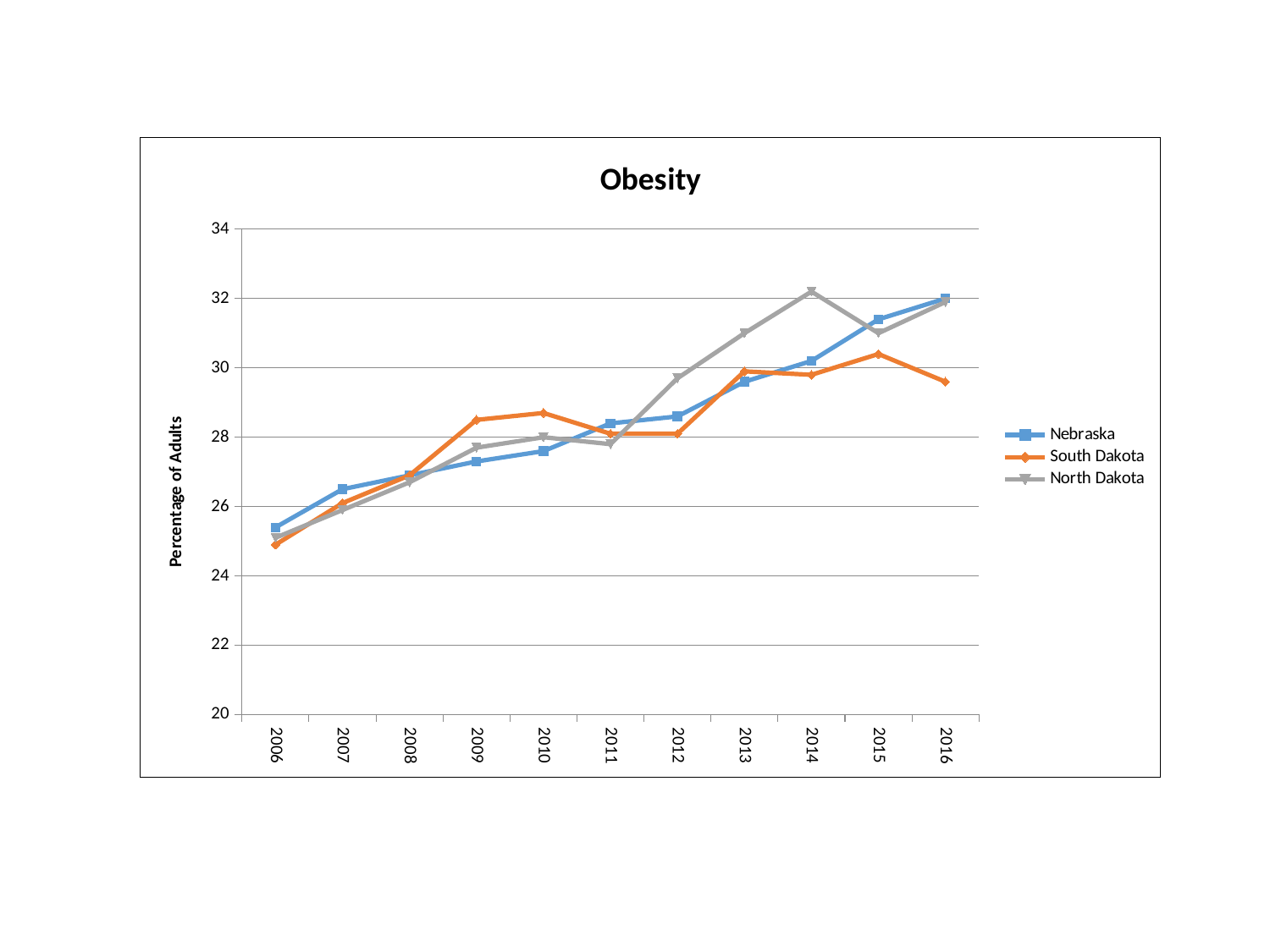
Does the Nebraska line generally rise or fall from 2006 to 2016? Rise Is the value for North Dakota in 2014 greater or less than 30? greater Is the value for Nebraska in 2016 greater or less than 30? greater Which series has the highest value in 2014? North Dakota What is the title of the chart? Obesity Is the value for South Dakota in 2006 greater or less than 26? less What is the label on the vertical axis? Percentage of Adults What kind of chart is shown on the slide? Line chart In 2016, which is larger, the value for Nebraska or the value for South Dakota? Nebraska How many series does the legend list? 3 How many years are shown on the x axis? 11 In 2009, which is larger, the value for South Dakota or the value for Nebraska? South Dakota